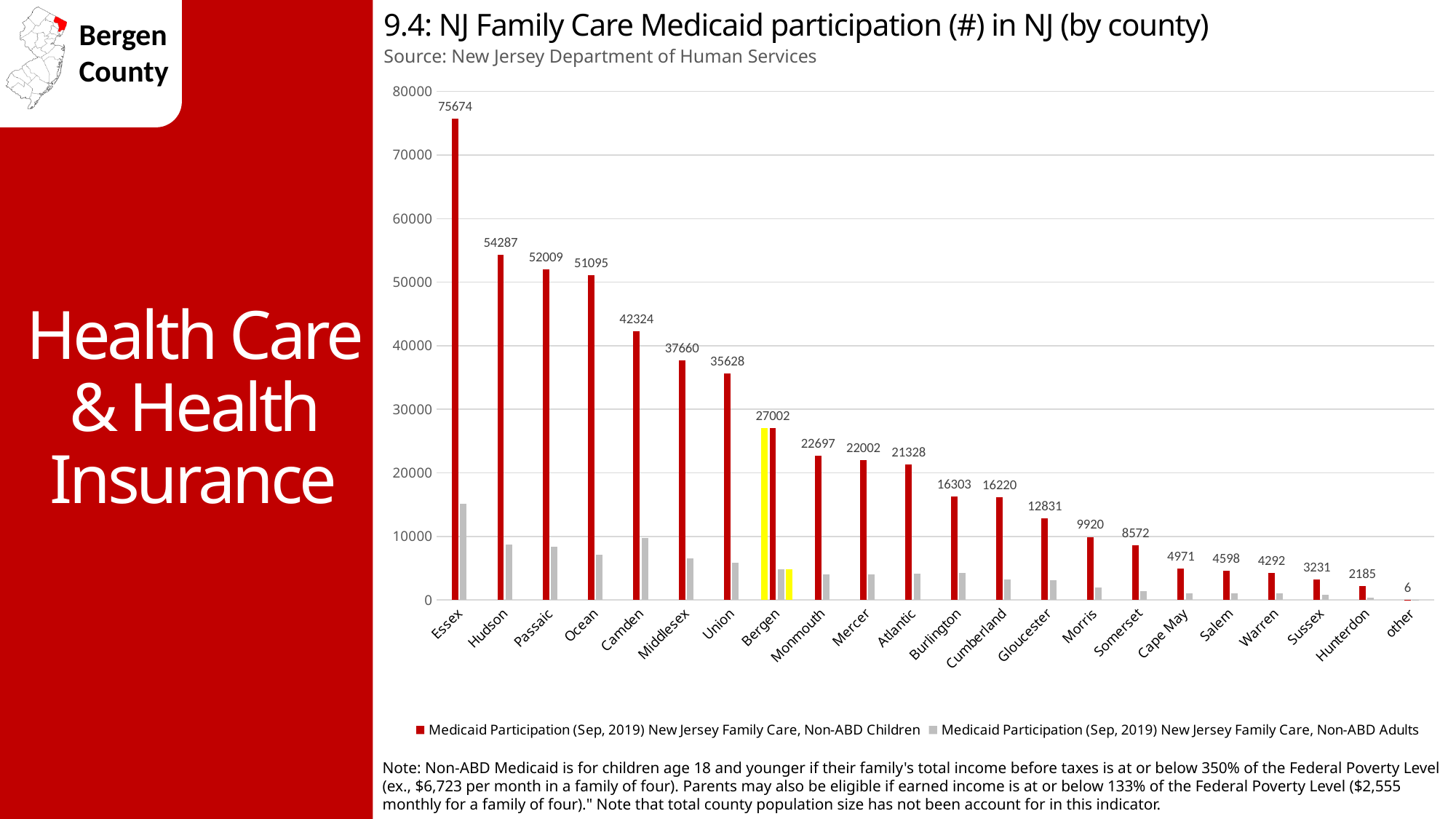
What kind of chart is shown on the slide? bar chart How many series does the legend list? 2 How many categories are shown on the x axis? 22 What is the Non-ABD Children Medicaid participation value for Cape May? 4971 Is the Non-ABD Adults value for Essex greater or less than 10000? greater What is the difference between the Non-ABD Children values for Hudson and Passaic? 2278 Which county has the highest Non-ABD Children Medicaid participation? Essex What is the Non-ABD Children Medicaid participation value for Bergen? 27002 Which category has the lowest Non-ABD Children Medicaid participation? other Which has a larger Non-ABD Children value, Camden or Middlesex? Camden Do the Non-ABD Children values rise or fall moving from Essex to Hunterdon along the x axis? fall What is the Non-ABD Children Medicaid participation value for Essex? 75674